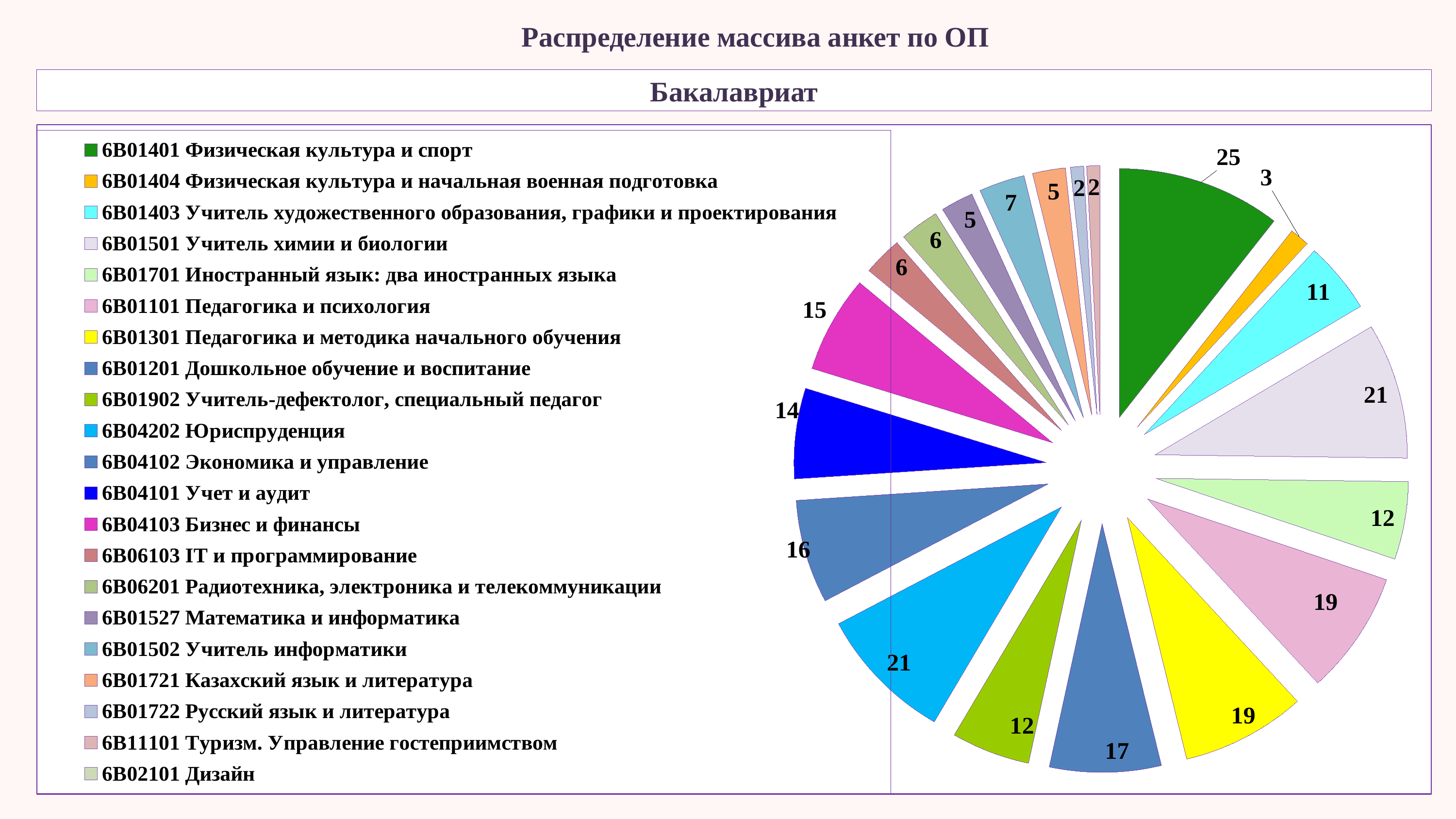
How many entries does the legend list? 21 What is the value for 6B01401 Физическая культура и спорт? 25 What is the title of the slide above the chart? Распределение массива анкет по ОП What is the difference between the values for 6B01401 Физическая культура и спорт and 6B04103 Бизнес и финансы? 10 What is the value for 6B01404 Физическая культура и начальная военная подготовка? 3 Which program has the largest slice in the pie chart? 6B01401 Физическая культура и спорт Which is larger: the value for 6B04102 Экономика и управление or the value for 6B01201 Дошкольное обучение и воспитание? 6B01201 Дошкольное обучение и воспитание What is the value for 6B01403 Учитель художественного образования, графики и проектирования? 11 What is the value for 6B04101 Учет и аудит? 14 What is the value for 6B01501 Учитель химии и биологии? 21 What is the value for 6B01502 Учитель информатики? 7 What type of chart is shown on the slide? pie chart